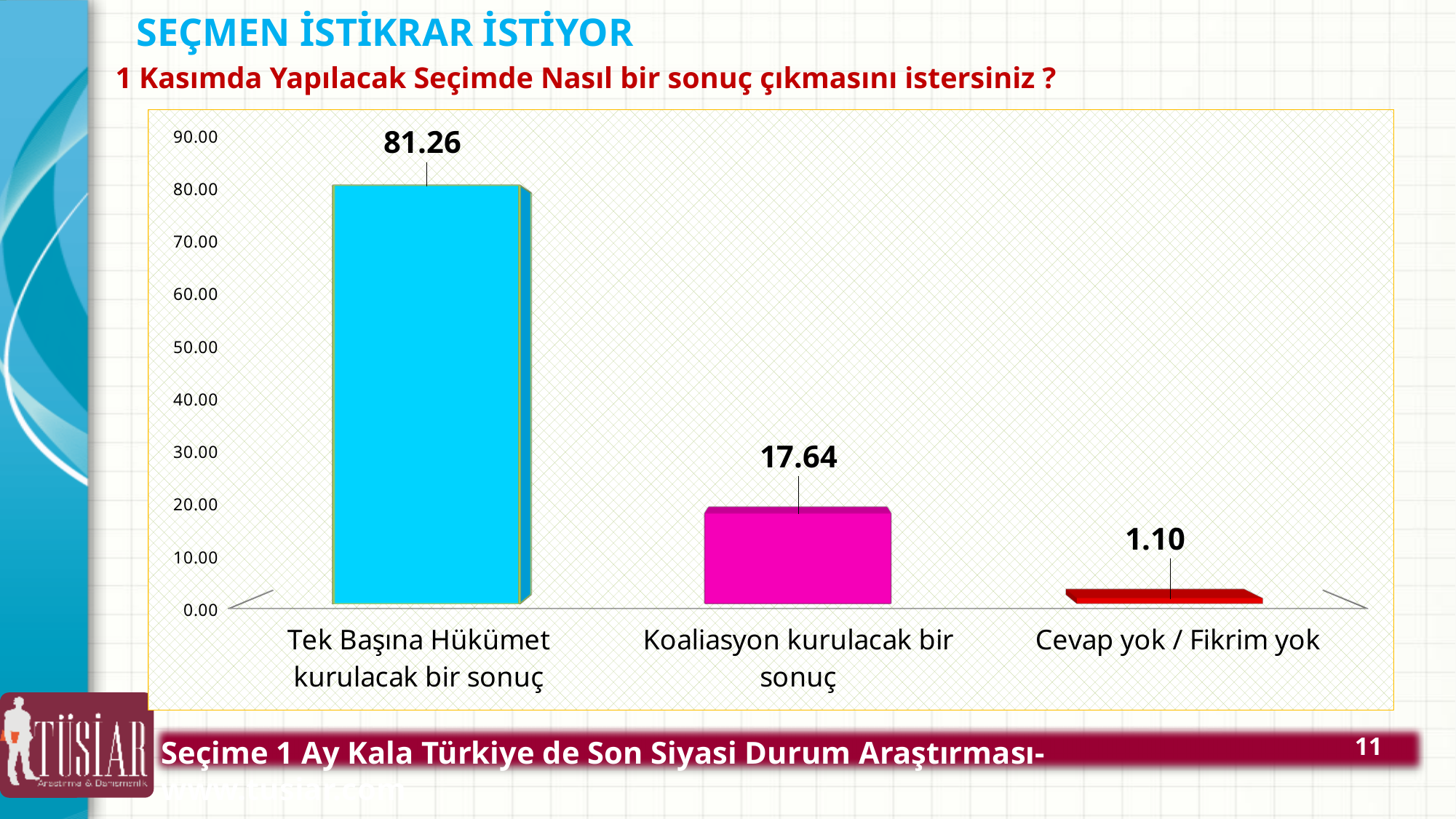
Which category has the highest value? Tek Başına Hükümet kurulacak bir sonuç Is the value for "Tek Başına Hükümet kurulacak bir sonuç" greater or less than 80.00? greater How many categories are shown on the chart? 3 Which category has the lowest value? Cevap yok / Fikrim yok What is the difference between the values for "Tek Başına Hükümet kurulacak bir sonuç" and "Koaliasyon kurulacak bir sonuç"? 63.62 What is the value for "Koaliasyon kurulacak bir sonuç"? 17.64 What is the difference between the values for "Koaliasyon kurulacak bir sonuç" and "Cevap yok / Fikrim yok"? 16.54 What is the value for "Cevap yok / Fikrim yok"? 1.10 What is the value for "Tek Başına Hükümet kurulacak bir sonuç"? 81.26 What kind of chart is shown on the slide? bar chart What colour is the bar for "Koaliasyon kurulacak bir sonuç"? magenta (pink) Which is larger: the value for "Koaliasyon kurulacak bir sonuç" or the value for "Cevap yok / Fikrim yok"? Koaliasyon kurulacak bir sonuç